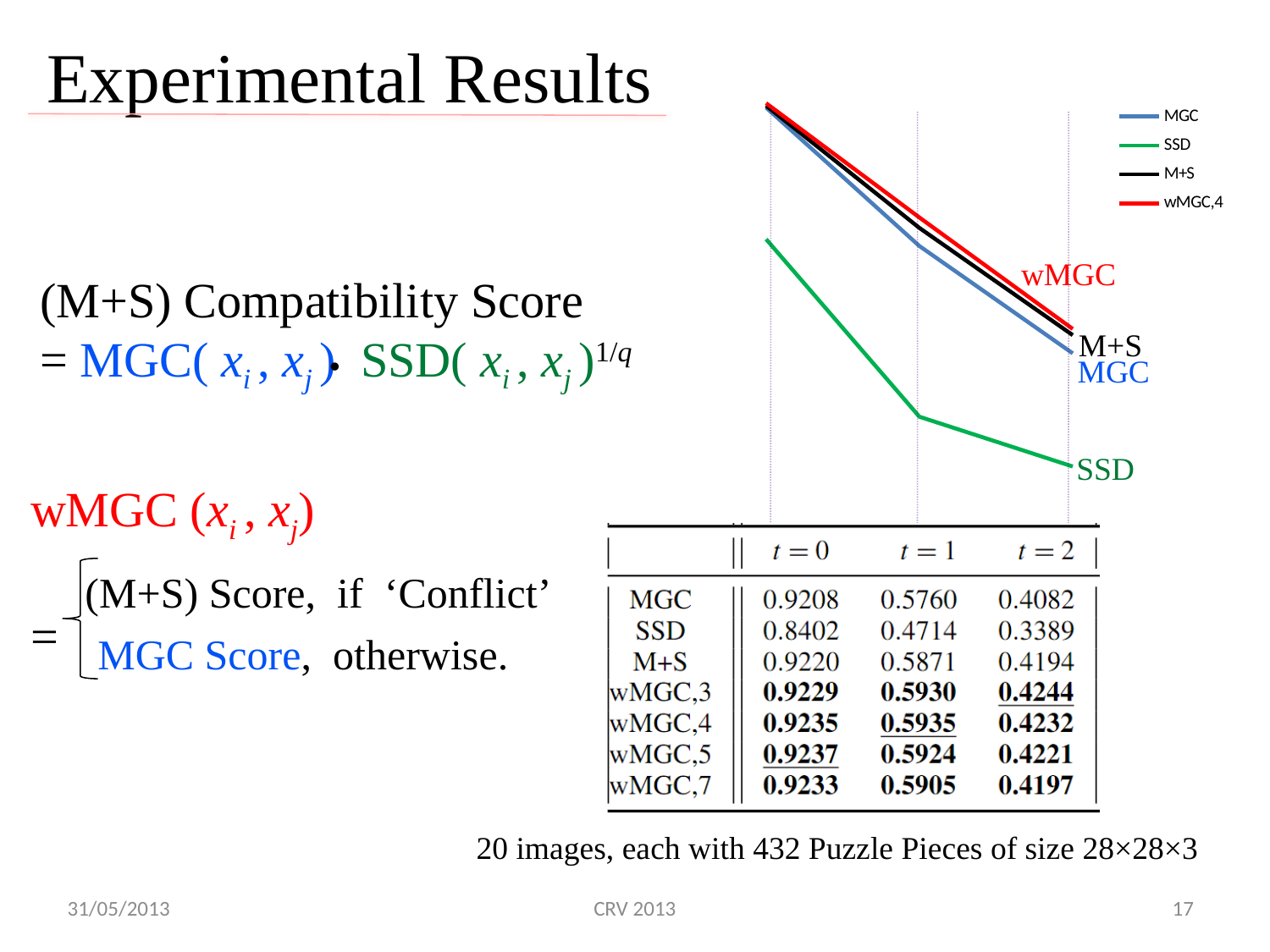
At t = 1, which is larger, the MGC value or the SSD value? MGC Which series are listed in the chart's legend? MGC, SSD, M+S, wMGC,4 How many points (t values) are plotted for each series? 3 What colour is the SSD line in the chart? green According to the table, what is the wMGC,4 value at t = 1? 0.5935 How many series does the chart's legend list? 4 What kind of chart is shown on the slide? line chart Which series has the lowest values across the chart? SSD Using the table values, what is the difference between MGC and SSD at t = 0? 0.0806 According to the table, what is the SSD value at t = 2? 0.3389 Do the plotted values rise or fall as t increases from 0 to 2? fall According to the table, what is the MGC value at t = 0? 0.9208